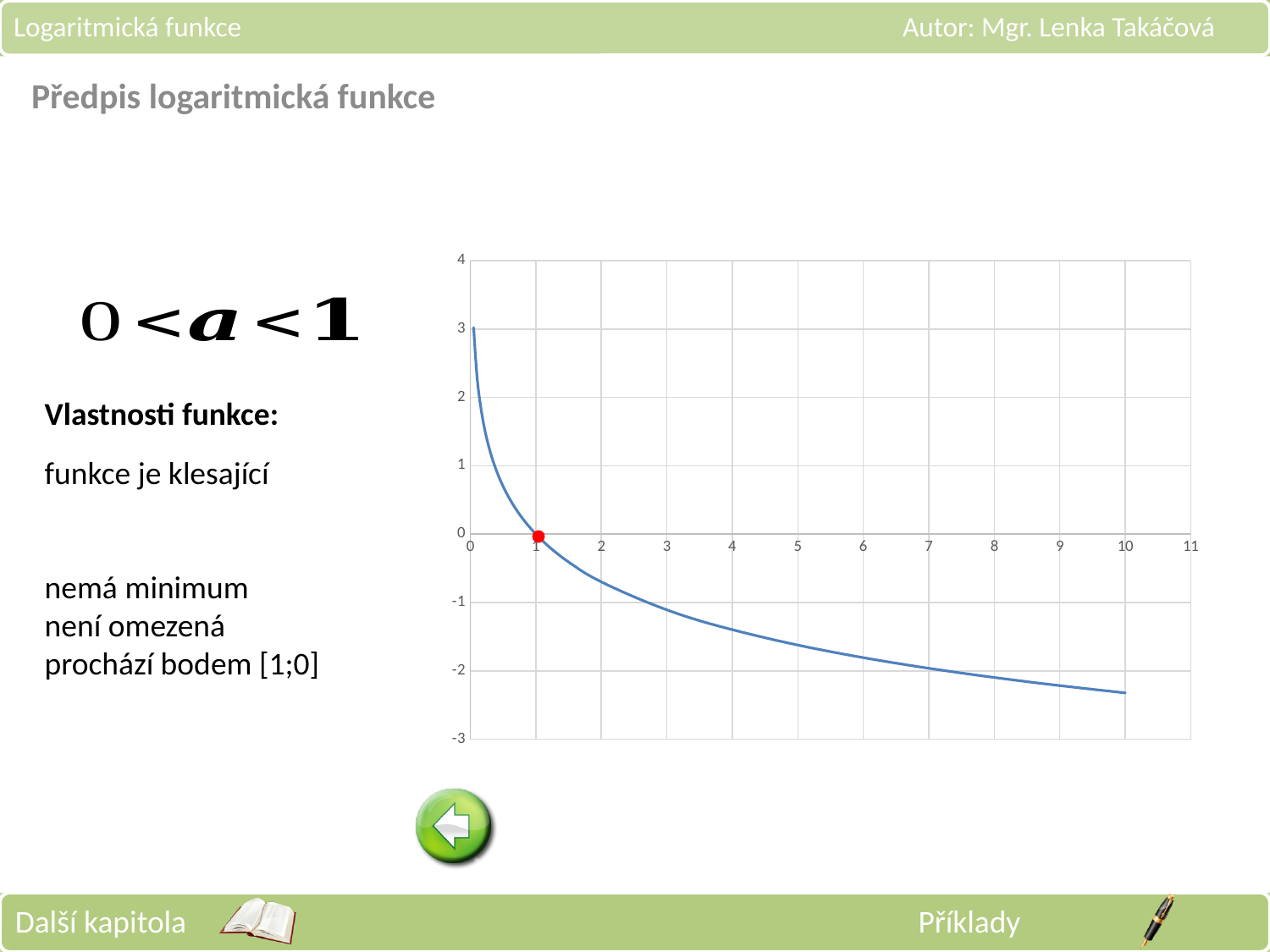
What is the highest value shown on the vertical axis? 4 What is the value of the function at x = 1, where the red point is marked? 0 Is the value of the function at x = 10 greater or less than -2? less Is the value of the function at x = 2 greater or less than 0? less What is the highest value shown on the horizontal axis? 11 Is the value of the function at x = 0.5 greater or less than 0? greater What kind of chart is shown on the slide? line chart Do the values of the plotted function rise or fall as x increases? fall